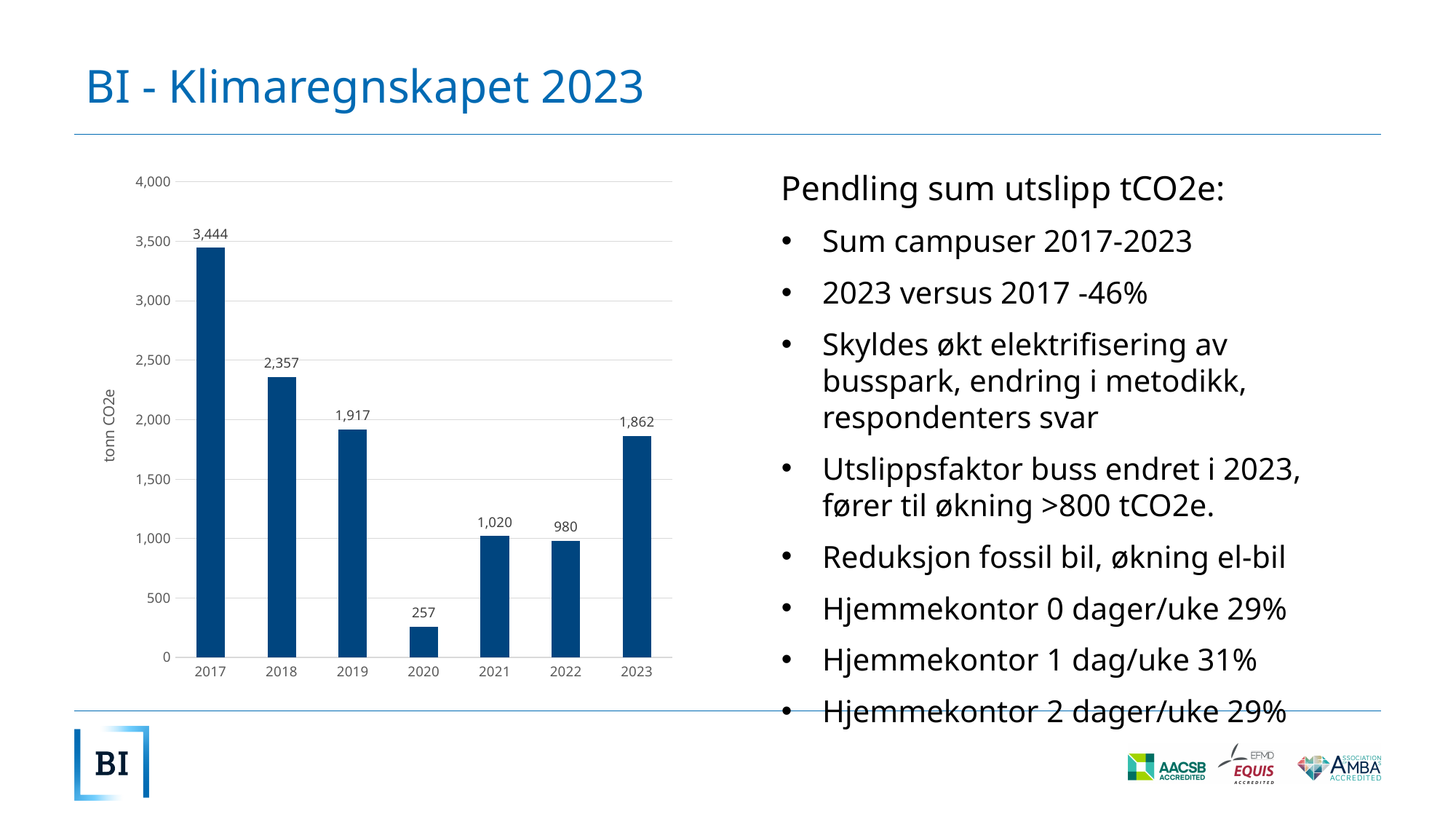
What kind of chart is shown on the slide? bar chart Which year has the lowest value? 2020 What is the value for 2020? 257 What is the label on the vertical axis of the chart? tonn CO2e Which year has the highest value? 2017 What is the difference between the values for 2021 and 2022? 40 How many years are shown on the x axis? 7 What is the difference between the values for 2017 and 2023? 1,582 Is the value for 2018 greater or less than 2,000? greater What is the value for 2017? 3,444 What is the value for 2023? 1,862 Which is larger, the value for 2019 or the value for 2023? 2019